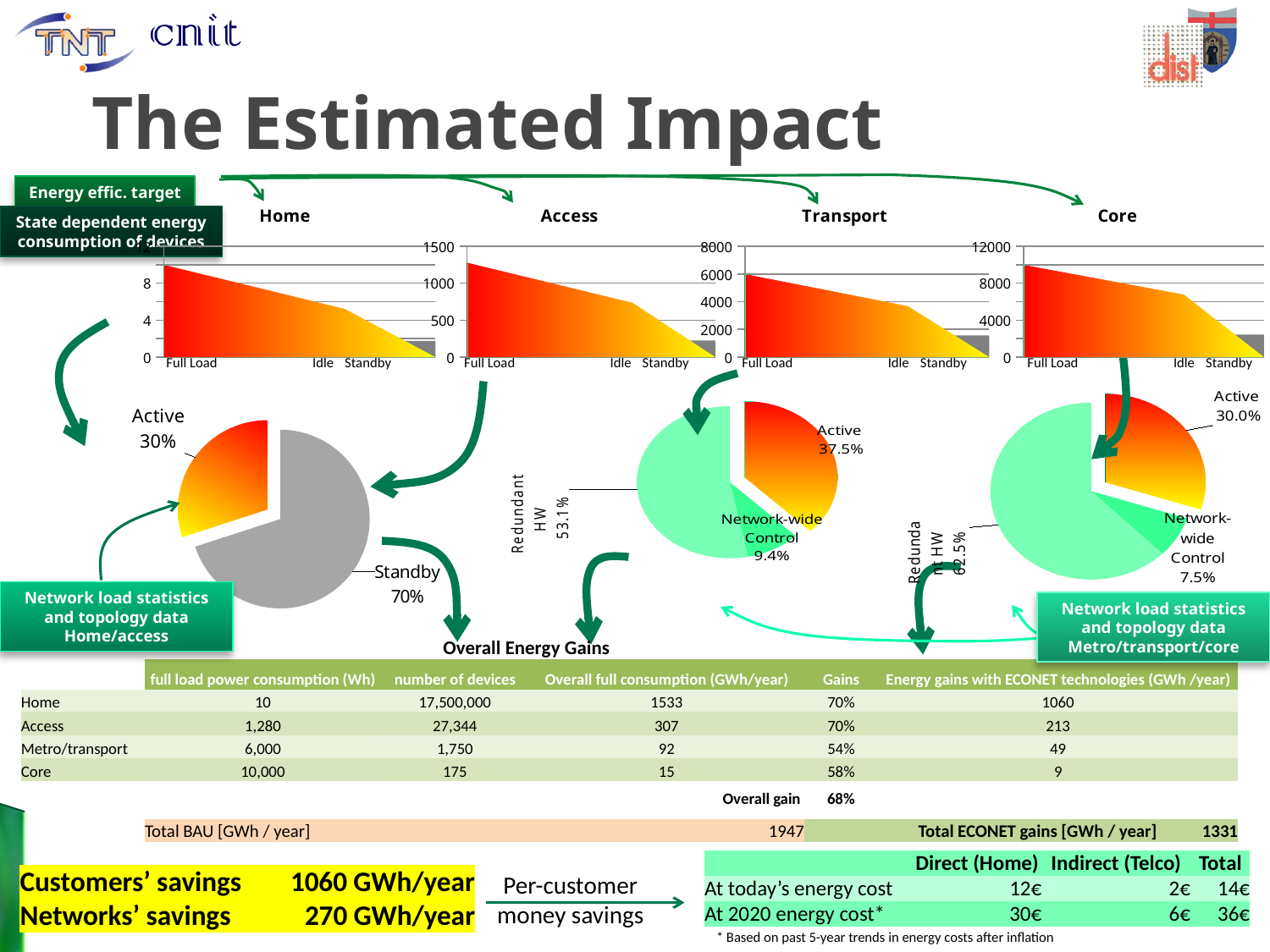
How many slices does the right pie chart have? 3 In the Transport chart, do the values rise or fall from Full Load to Standby? fall In the Home chart, is the value for Full Load greater or less than 8? greater In the left pie chart (below the Home chart), what share is Standby? 70% In the middle pie chart, what share is Active? 37.5% In the right pie chart, what share is Network-wide Control? 7.5% In the right pie chart, what is the difference between the Redundant HW share and the Active share? 32.5% In the Core chart, is the value for Full Load greater or less than 8000? greater What kind of chart is the Home chart at the top of the slide? area chart In the Access chart, is the value for Full Load greater or less than 1000? greater In the middle pie chart, which slice is the largest? Redundant HW How many categories are shown on the x axis of the Home chart? 3